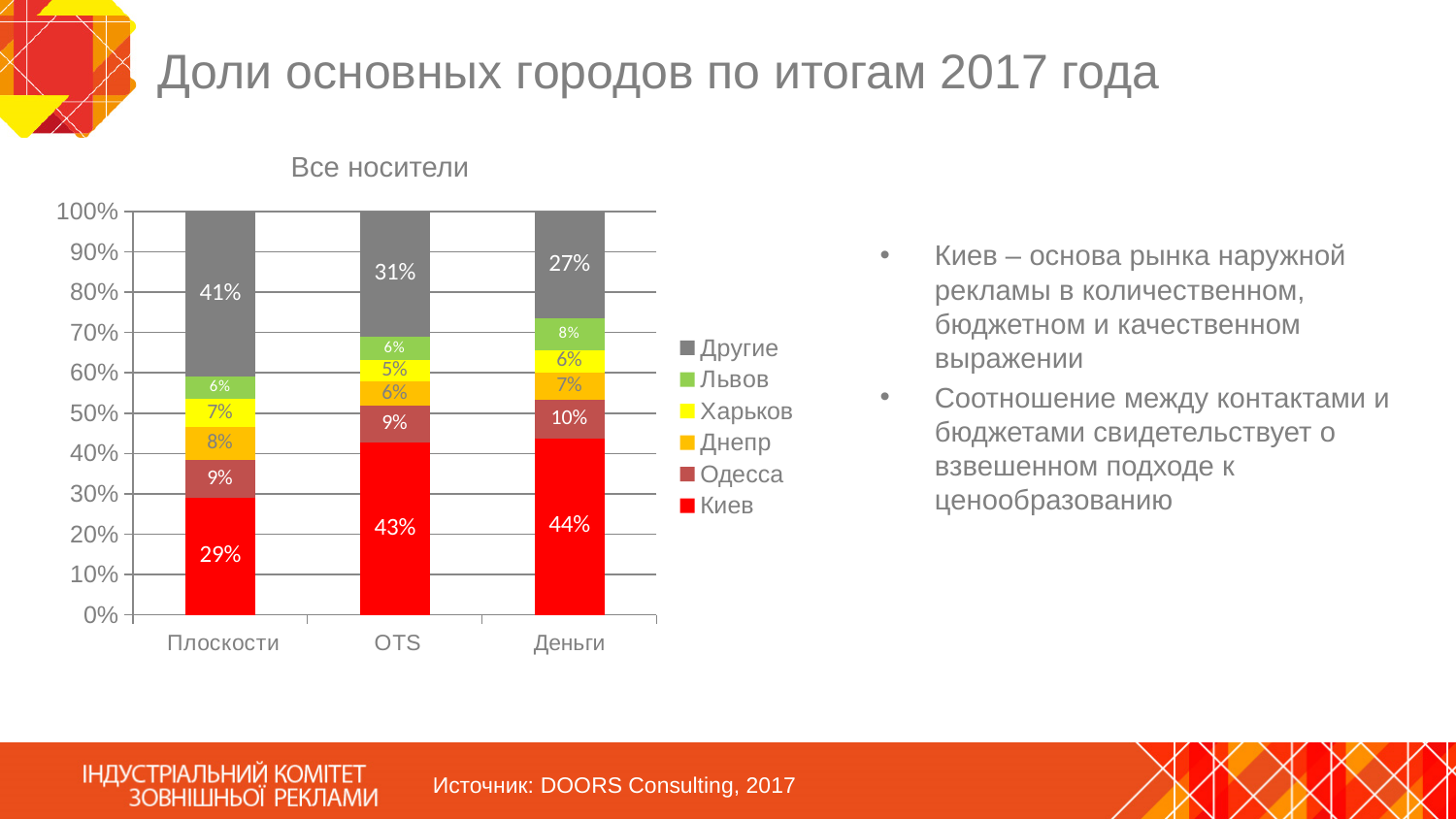
What is the value for Другие in the OTS bar? 31% In which category is the Другие share lowest? Деньги What is the difference between the Другие share in Плоскости and in Деньги? 14% What kind of chart is shown on the slide? Stacked bar chart What is the value for Одесса in the Деньги bar? 10% What is the value for Львов in the Деньги bar? 8% How many categories are shown on the x axis? 3 What is the title of the chart? Все носители In which category is the Киев share highest? Деньги How many series does the legend list? 6 What is the value for Киев in the Плоскости bar? 29% Which is larger: the Киев share in OTS or the Киев share in Плоскости? Киев share in OTS